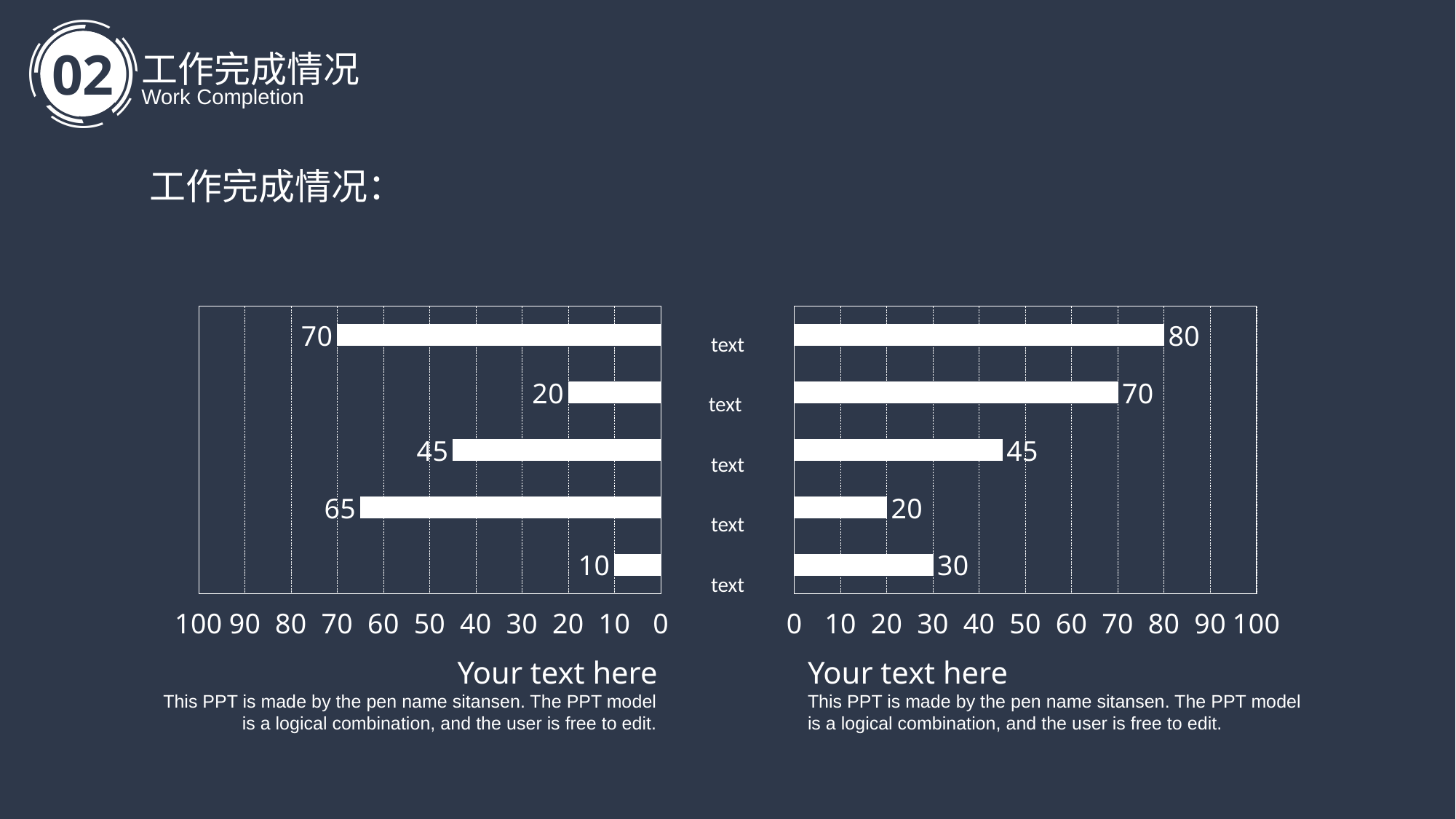
In the right chart, what is the difference between the top bar (80) and the bottom bar (30)? 50 In the left chart, what is the value of the top bar? 70 In the right chart, what is the lowest value shown? 20 How many bars does the left chart have? 5 In the left chart, what is the lowest value shown? 10 In the right chart, what is the value of the bottom bar? 30 In the left chart, what is the difference between the top bar (70) and the second bar (20)? 50 In the right chart, which is larger: the second bar from the top or the third bar from the top? the second bar (70) What kind of chart is the left chart on the slide? bar chart In the right chart, what is the value of the top bar? 80 In the left chart, what is the value of the bottom bar? 10 In the left chart, what is the highest value shown? 70